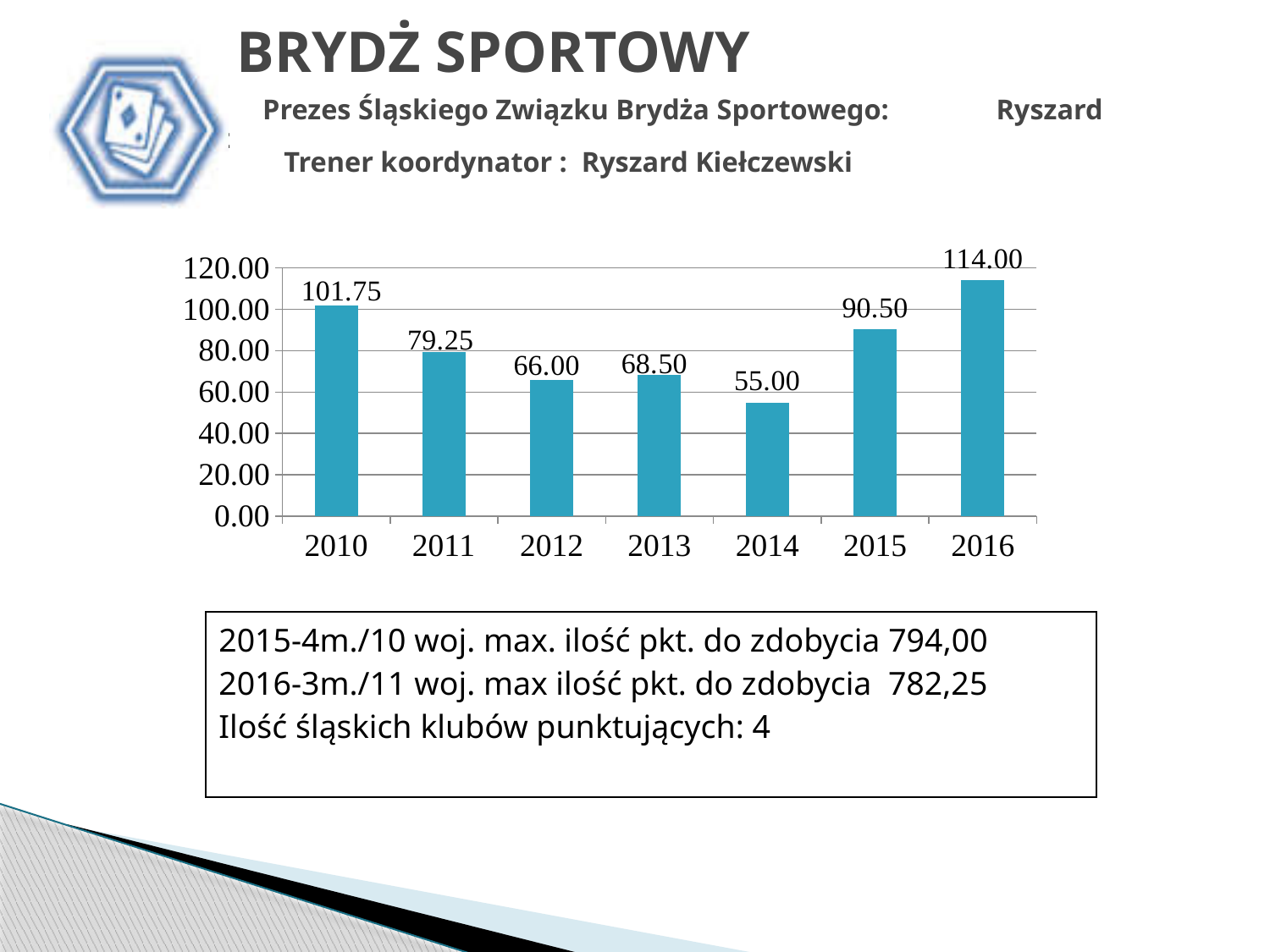
Which year has the lowest value? 2014 How many years are shown on the x axis? 7 What is the difference between the values for 2010 and 2011? 22.50 What is the value for 2016? 114.00 What kind of chart is shown on the slide? bar chart What is the value for 2014? 55.00 Which year has the highest value? 2016 Is the value for 2015 greater or less than 80.00? greater What is the value for 2010? 101.75 What is the difference between the values for 2016 and 2015? 23.50 What is the value for 2013? 68.50 Which is larger, the value for 2012 or the value for 2013? 2013